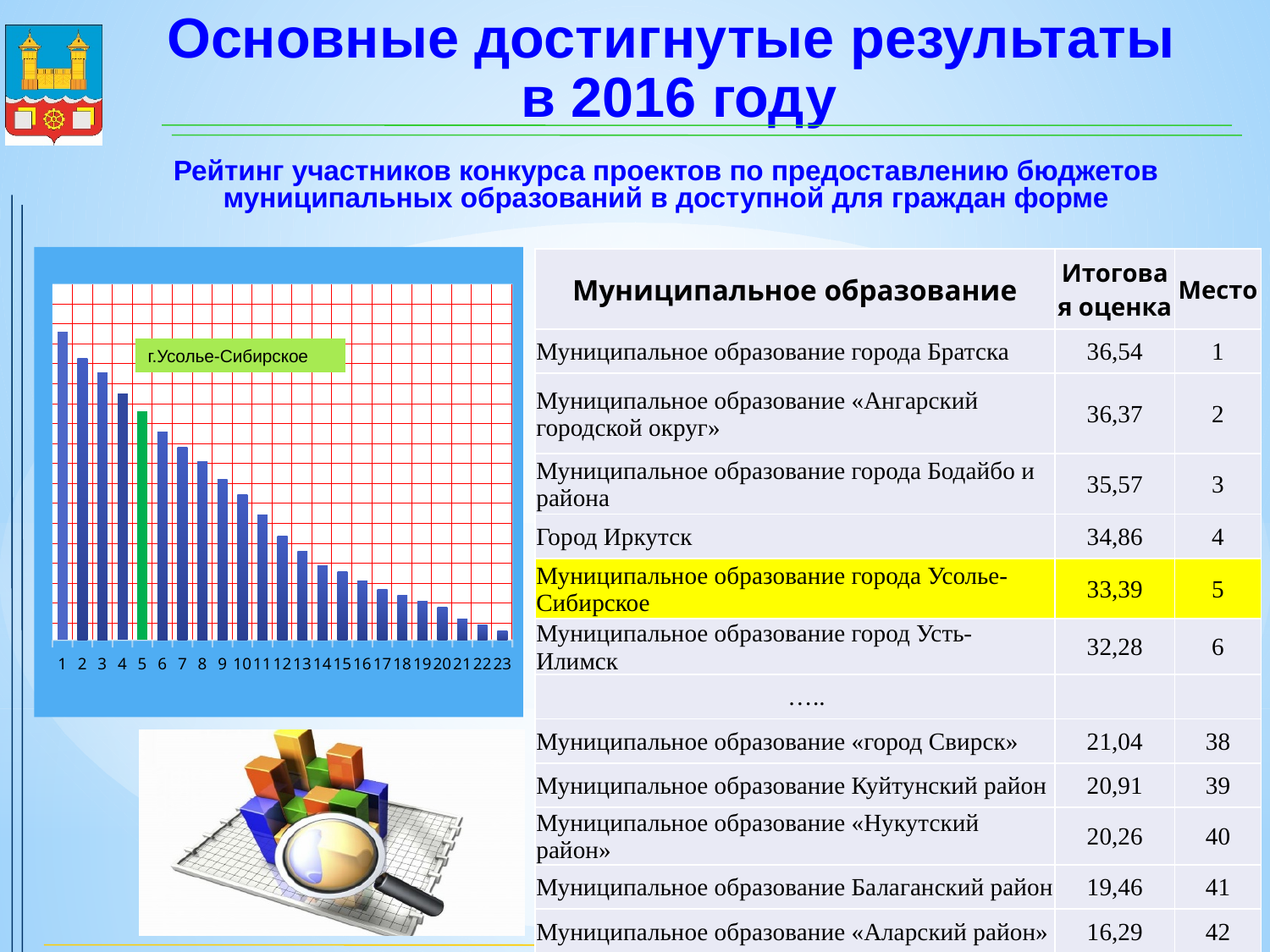
In the chart on the left, which bar is taller: category 20 or category 8? 8 In the chart on the left, which category has the tallest bar? 1 In the chart on the left, which bar is taller: category 3 or category 12? 3 In the chart on the left, do the bar heights rise or fall from category 1 to category 23? fall In the chart on the left, which category has the shortest bar? 23 What kind of chart is shown on the left of the slide? bar chart In the chart on the left, which category is highlighted with a green bar? 5 How many bars are plotted in the chart on the left of the slide? 23 In the chart on the left, what label is shown in the green box next to the highlighted bar? г.Усолье-Сибирское